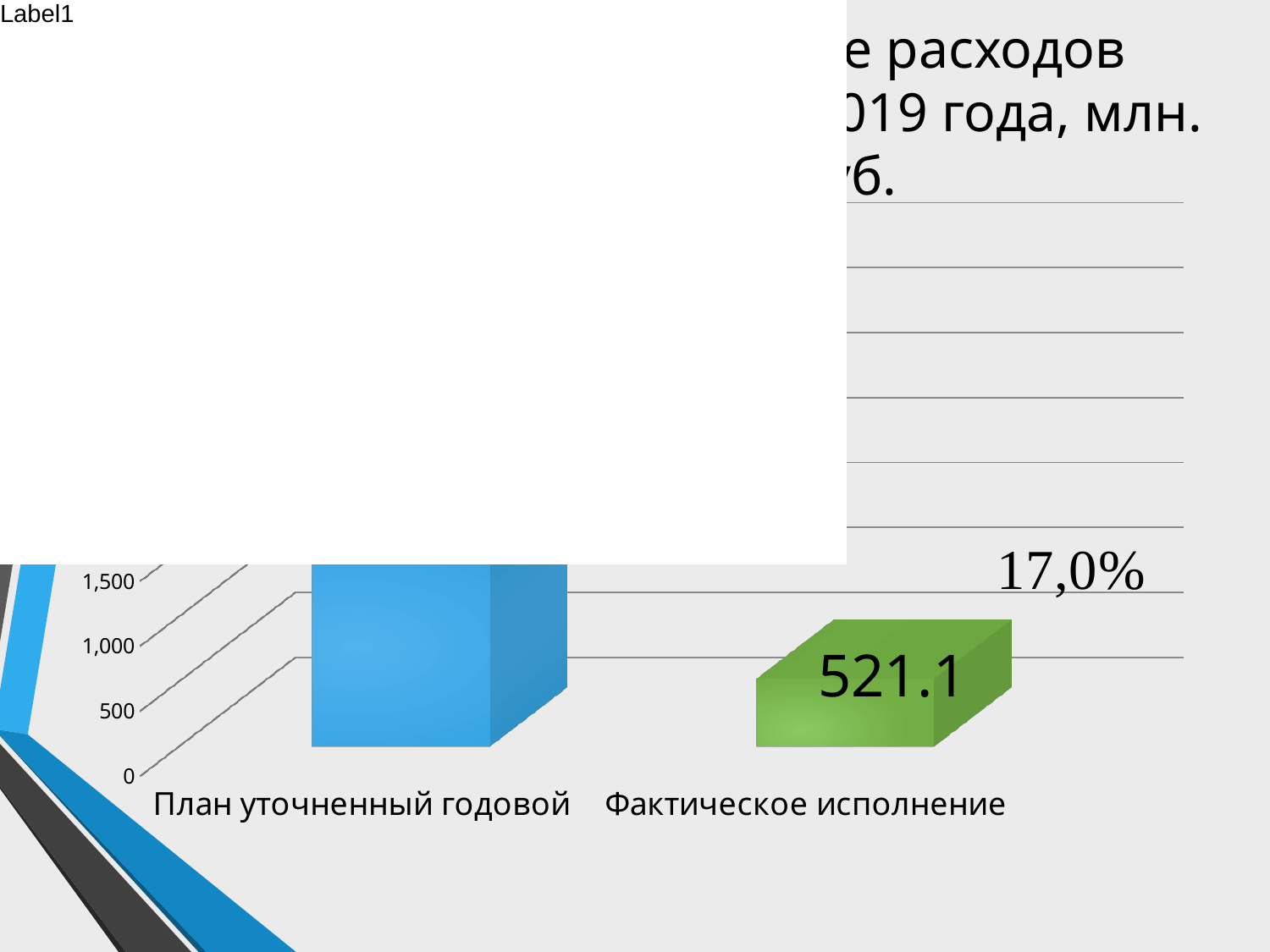
What is the value shown for Фактическое исполнение? 521.1 Which category has the lowest bar? Фактическое исполнение Which is larger, the bar for План уточненный годовой or the bar for Фактическое исполнение? План уточненный годовой Is the value for Фактическое исполнение greater or less than 1,000? less How many categories are shown on the x axis of the chart? 2 What percentage is printed next to the Фактическое исполнение bar? 17,0% What kind of chart is shown on the slide? bar chart What colour is the bar for Фактическое исполнение? green Is the value for План уточненный годовой greater or less than 1,500? greater Which category has the highest bar? План уточненный годовой